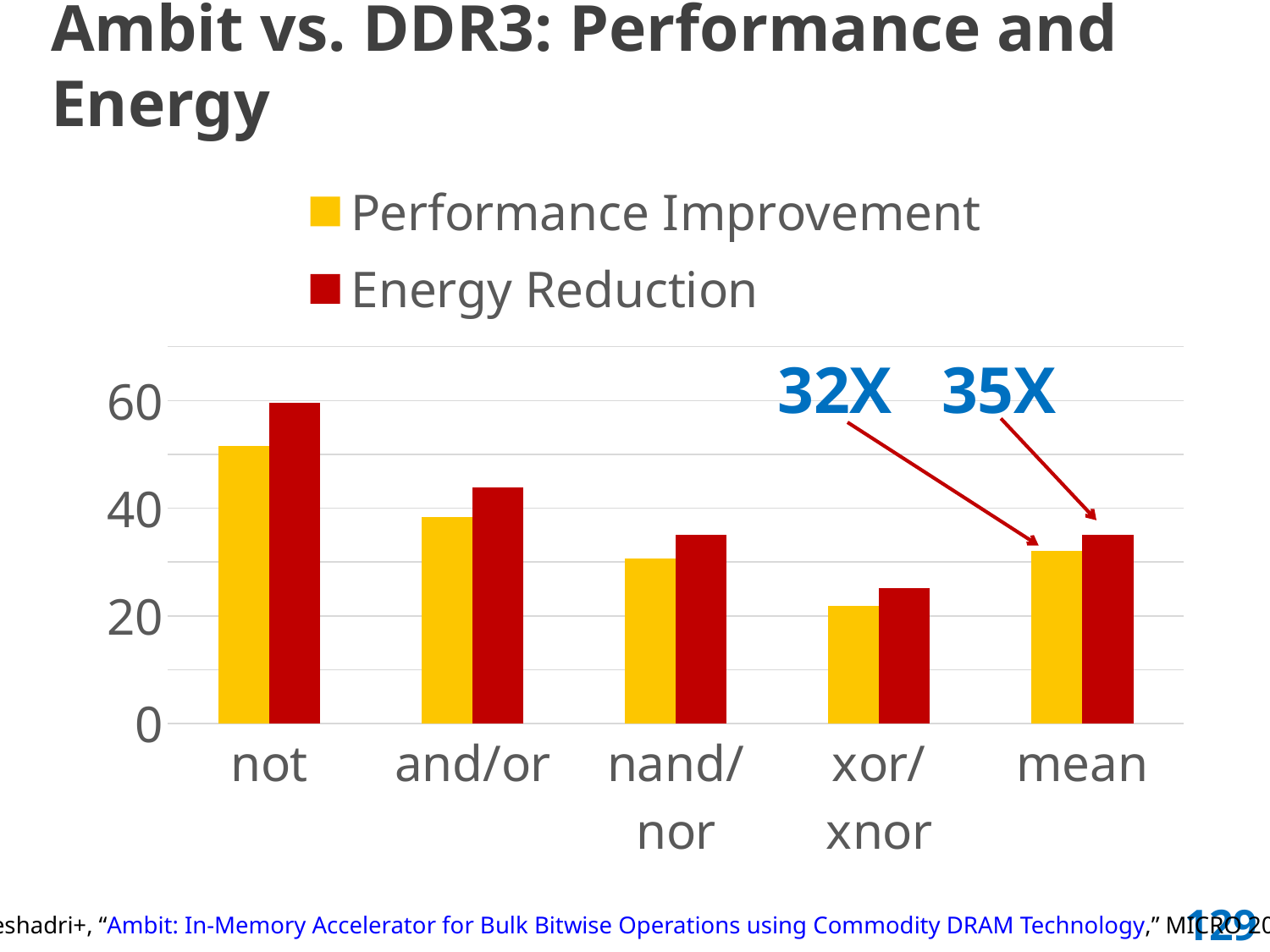
Is the Energy Reduction value for not greater or less than 40? greater Which has a larger Performance Improvement bar, not or and/or? not What is the Performance Improvement value for the mean category? 32X What is the difference between the Energy Reduction and Performance Improvement values for the mean category? 3X Which category has the highest Energy Reduction bar? not How many categories are shown on the x axis? 5 What kind of chart is shown on the slide? bar chart Is the Energy Reduction value for nand/nor greater or less than 40? less Is the Performance Improvement value for xor/xnor greater or less than 40? less What is the Energy Reduction value for the mean category? 35X Which category has the lowest Performance Improvement bar? xor/xnor How many series does the legend list? 2